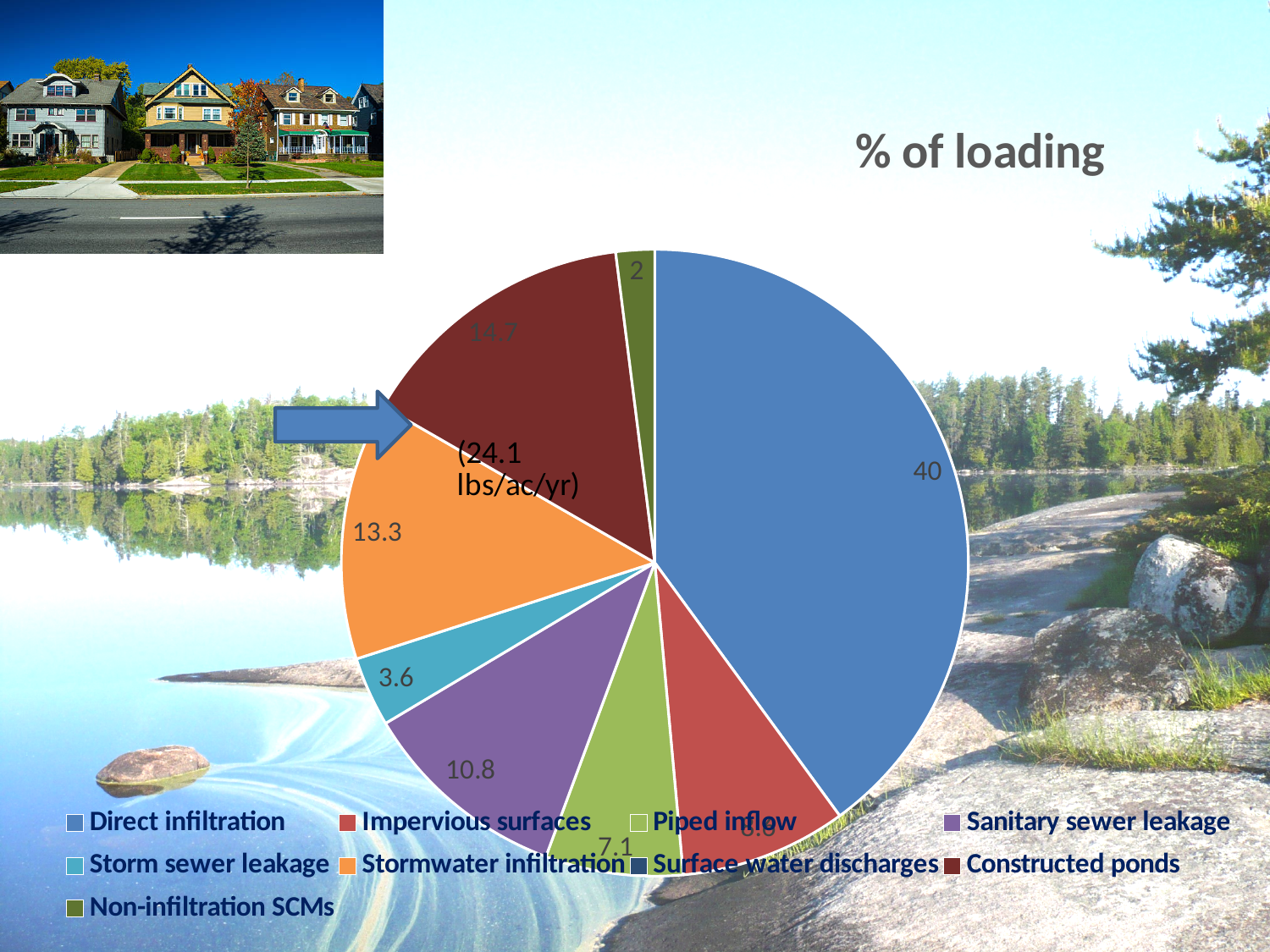
Which is larger in the pie chart, Constructed ponds or Stormwater infiltration? Constructed ponds What value is shown for Constructed ponds in the pie chart? 14.7 Which category has the largest slice in the pie chart? Direct infiltration What is the title of the pie chart? % of loading What value is shown for Direct infiltration in the pie chart? 40 What kind of chart is shown on the slide? pie chart What value is shown for Sanitary sewer leakage in the pie chart? 10.8 What value is shown for Non-infiltration SCMs in the pie chart? 2 What value is shown for Stormwater infiltration in the pie chart? 13.3 How many entries does the legend of the pie chart list? 9 What value is shown for Storm sewer leakage in the pie chart? 3.6 What is the difference between the values for Direct infiltration and Constructed ponds in the pie chart? 25.3